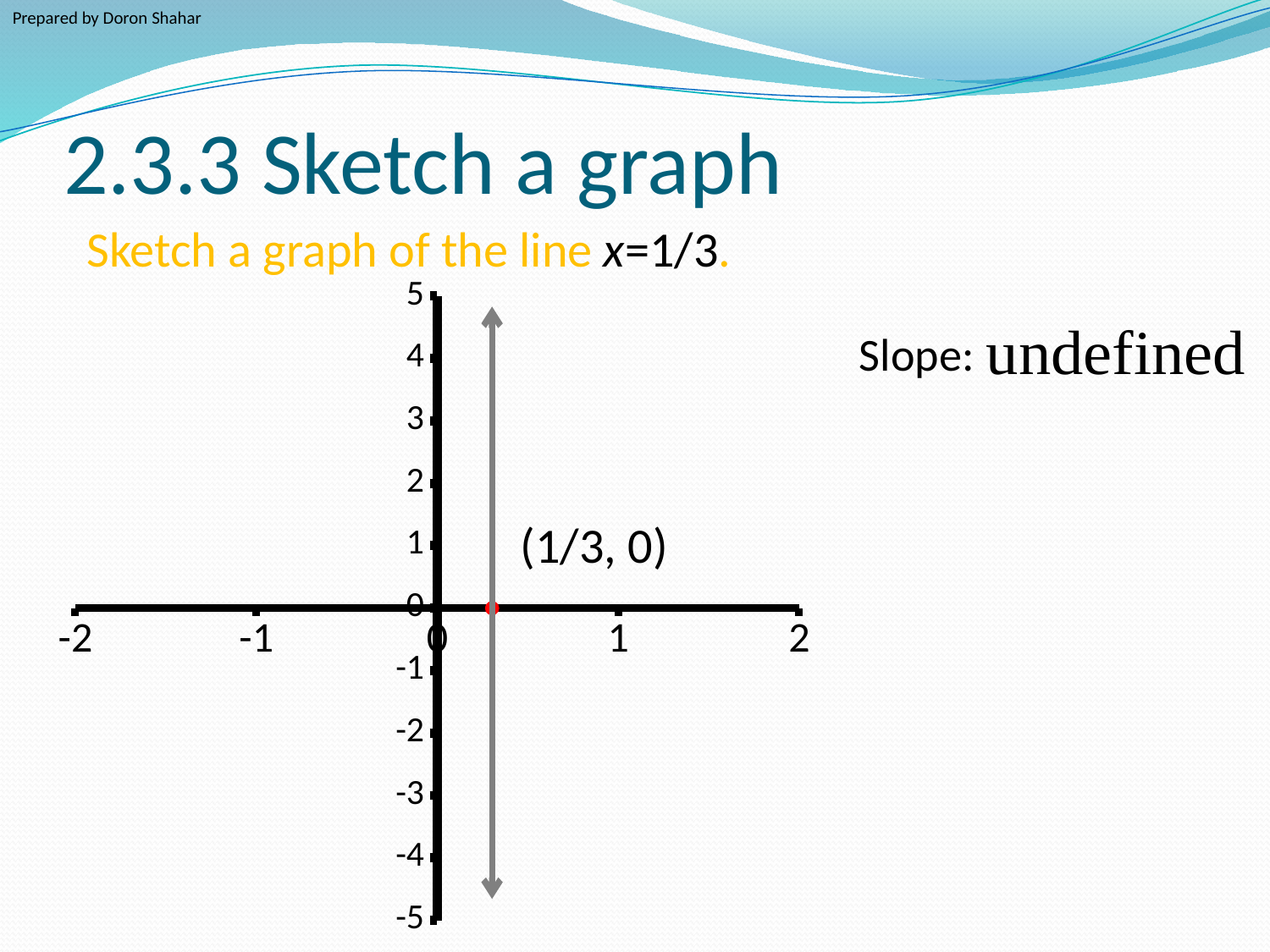
What is the lowest value shown on the x axis? -2 What is the equation of the line sketched on the graph? x=1/3 What is the highest value shown on the x axis? 2 What is the highest value shown on the y axis? 5 Is the x-coordinate of the labeled point greater or less than 0? greater What is the y-coordinate of the labeled point on the graph? 0 What are the coordinates of the point labeled on the graph? (1/3, 0) How many points are labeled with coordinates on the graph? 1 Is the line drawn on the graph vertical or horizontal? vertical What is the lowest value shown on the y axis? -5 What is the slope of the line shown on the graph? undefined Is the x-coordinate of the labeled point greater or less than 1? less